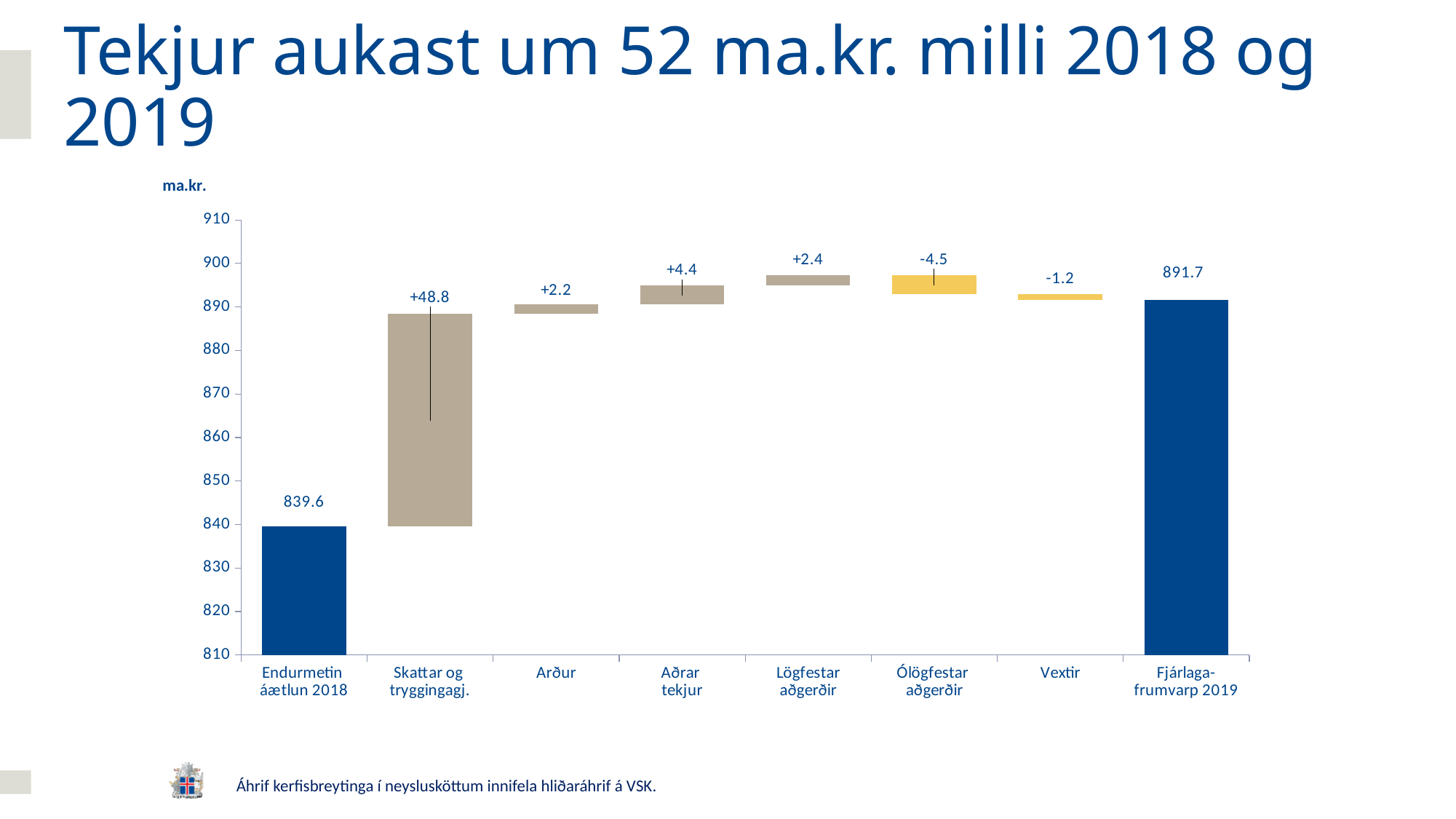
How many categories are shown on the x axis? 8 Which category shows the largest negative change? Ólögfestar aðgerðir What is the difference between the Fjárlagafrumvarp 2019 value and the Endurmetin áætlun 2018 value? 52.1 What is the value for Fjárlagafrumvarp 2019? 891.7 What change is shown for Ólögfestar aðgerðir? -4.5 Which category shows the largest positive change? Skattar og tryggingagj. What change is shown for Skattar og tryggingagj.? +48.8 What kind of chart is shown on the slide? Bar chart (waterfall) Which change is larger, Aðrar tekjur or Arður? Aðrar tekjur What change is shown for Vextir? -1.2 What is the value for Endurmetin áætlun 2018? 839.6 What unit is shown above the y axis? ma.kr.